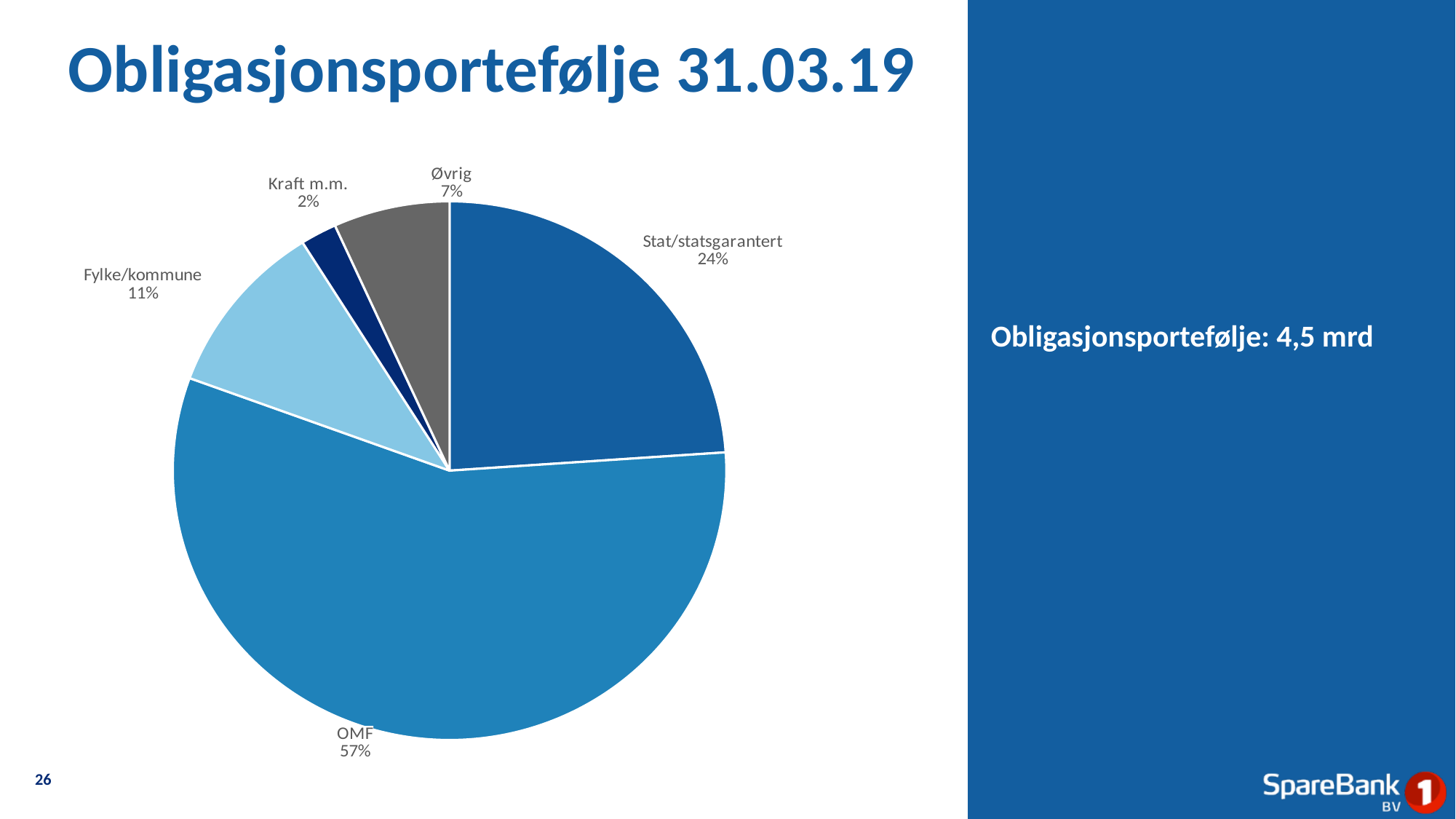
How many categories are shown in the pie chart? 5 What is the total size of the bond portfolio stated on the slide? 4,5 mrd What share of the bond portfolio is Kraft m.m.? 2% What share of the bond portfolio is Øvrig? 7% What share of the bond portfolio is Fylke/kommune? 11% Which is larger, Fylke/kommune or Øvrig? Fylke/kommune Which category has the largest share of the pie? OMF What type of chart is shown on the slide? pie chart Which category has the smallest share of the pie? Kraft m.m. What share of the bond portfolio is OMF? 57% What share of the bond portfolio is Stat/statsgarantert? 24% What is the difference in percentage points between OMF and Stat/statsgarantert? 33